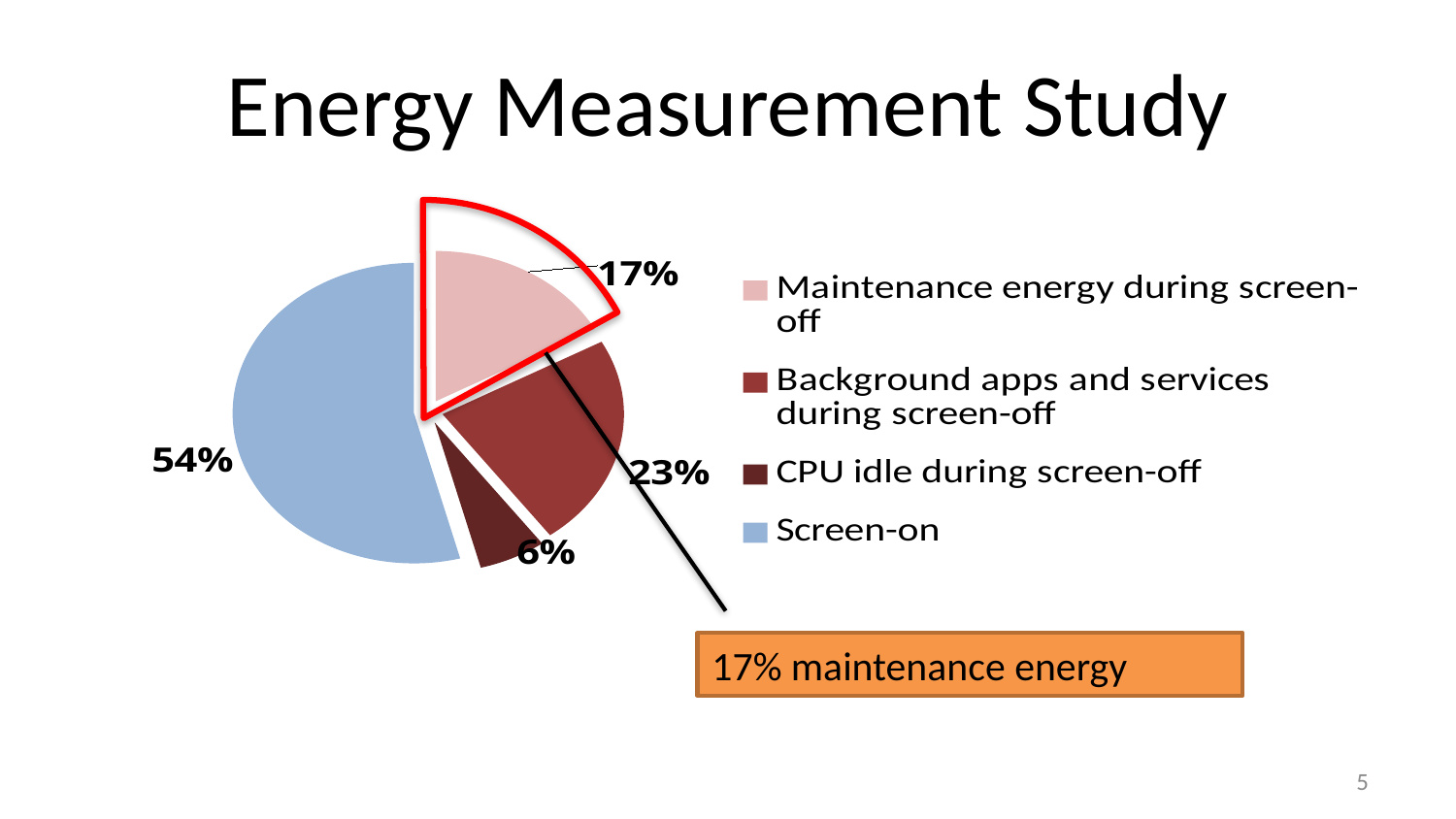
What share of the pie is Screen-on? 54% How many slices does the pie chart have? 4 What share of the pie is Background apps and services during screen-off? 23% Which slice of the pie is outlined in red? Maintenance energy during screen-off What share of the pie is Maintenance energy during screen-off? 17% Which category has the smallest slice of the pie? CPU idle during screen-off How many entries does the legend list? 4 Which is larger: the Maintenance energy during screen-off slice or the CPU idle during screen-off slice? Maintenance energy during screen-off What kind of chart is shown on the slide? pie chart Which category has the largest slice of the pie? Screen-on What is the difference between the Screen-on share and the Background apps and services during screen-off share? 31%